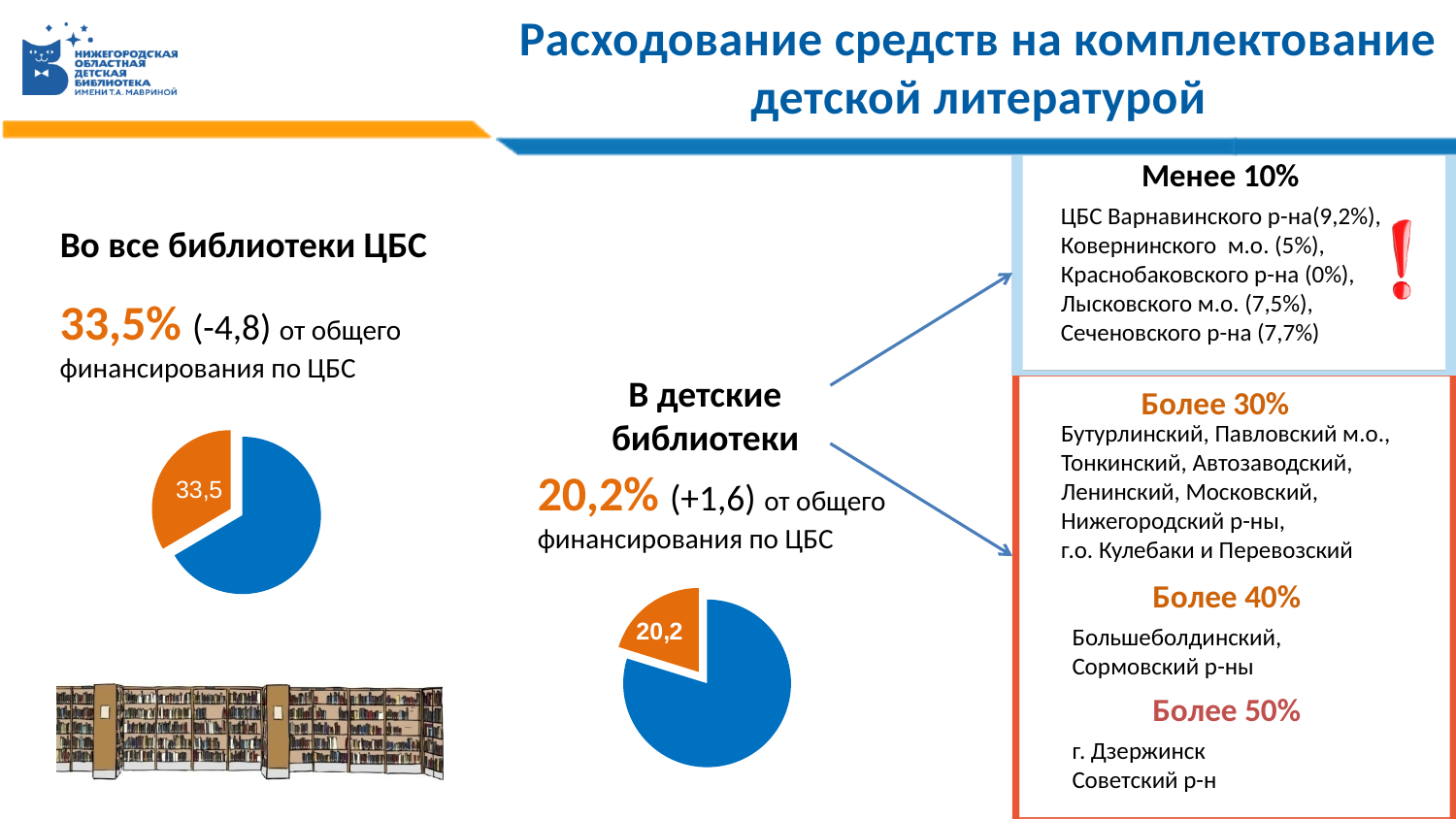
In the pie chart under "В детские библиотеки", what value is printed on the orange slice? 20,2 Which pie chart has the larger labelled orange slice, the one under "Во все библиотеки ЦБС" or the one under "В детские библиотеки"? Во все библиотеки ЦБС How many slices does the pie chart under "В детские библиотеки" have? 2 In the pie chart under "Во все библиотеки ЦБС", which slice is larger, the orange one or the blue one? blue What colour is the unlabelled, larger slice in both pie charts? blue How many slices does the pie chart under "Во все библиотеки ЦБС" have? 2 What colour is the labelled slice in both pie charts? orange What type of chart is shown under "Во все библиотеки ЦБС"? pie chart What is the difference between the labelled slice values of the two pie charts (33,5 and 20,2)? 13,3 What type of chart is shown under "В детские библиотеки"? pie chart In the pie chart under "Во все библиотеки ЦБС", what value is printed on the orange slice? 33,5 In the pie chart under "В детские библиотеки", which slice is larger, the orange one or the blue one? blue